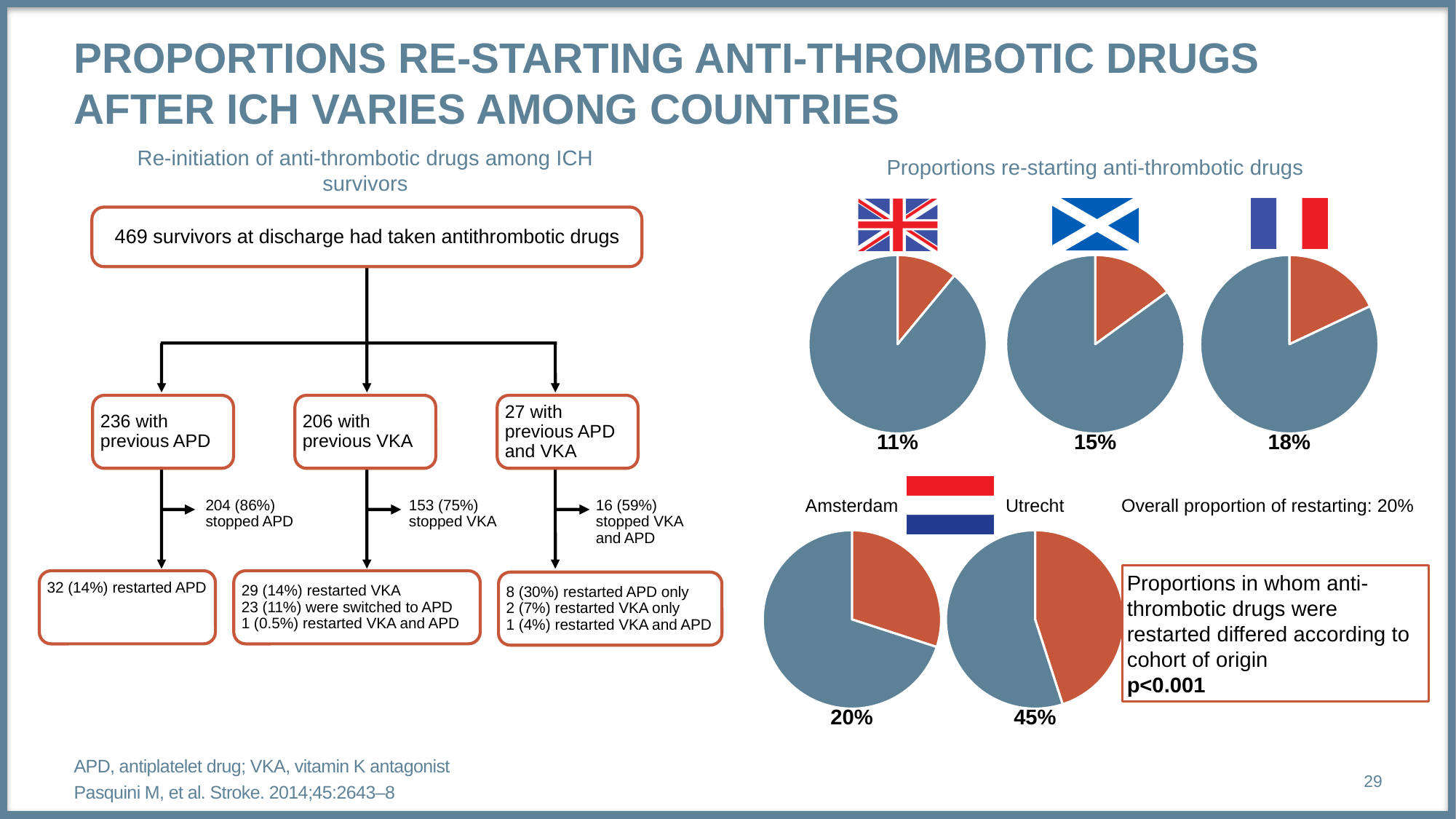
What kind of charts are shown under the heading 'Proportions re-starting anti-thrombotic drugs'? Pie charts How many pie charts are shown on the slide? 5 In the pie chart labelled Amsterdam, what proportion re-started anti-thrombotic drugs? 20% What percentage is shown under the rightmost pie chart in the top row (under the French flag)? 18% What is the difference between the Utrecht and Amsterdam proportions re-starting anti-thrombotic drugs? 25 percentage points Which is larger: the proportion re-starting under the Scottish flag pie chart or under the French flag pie chart? French flag (18%) What percentage is shown under the middle pie chart in the top row (under the Scottish flag)? 15% In the pie chart labelled Utrecht, what proportion re-started anti-thrombotic drugs? 45% What percentage is shown under the leftmost pie chart in the top row (under the Union Jack flag)? 11% What overall proportion of restarting is stated on the slide? 20% Which of the five pie charts shows the highest proportion re-starting anti-thrombotic drugs? Utrecht (45%) Which of the five pie charts shows the lowest proportion re-starting anti-thrombotic drugs? The one under the Union Jack flag (11%)